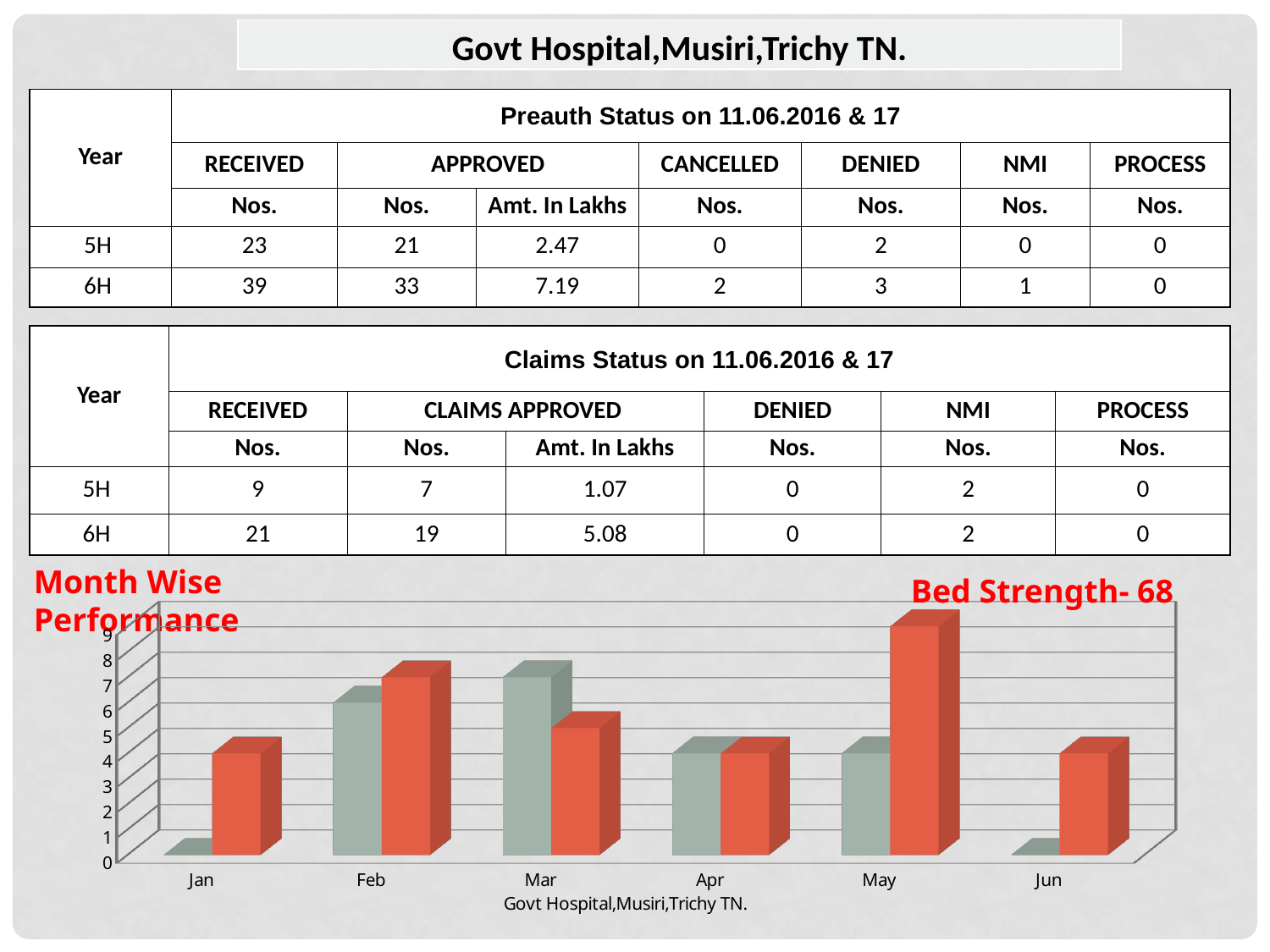
What is the title written above the bar chart? Month Wise Performance In the Month Wise Performance chart, is the grey bar for Jan greater or less than 2? less In the Month Wise Performance chart, for Mar, which bar is taller: the grey bar or the orange bar? grey In the Month Wise Performance chart, which month has the tallest orange bar? May What kind of chart is shown at the bottom of the slide? bar chart How many months are shown on the x axis of the Month Wise Performance chart? 6 In the Month Wise Performance chart, which is taller: the grey bar for Mar or the grey bar for Apr? Mar In the Month Wise Performance chart, is the orange bar for Apr greater or less than 6? less What label appears below the x axis of the bar chart? Govt Hospital,Musiri,Trichy TN. In the Month Wise Performance chart, which is taller: the orange bar for May or the orange bar for Jun? May In the Month Wise Performance chart, is the grey bar for Feb greater or less than 5? greater